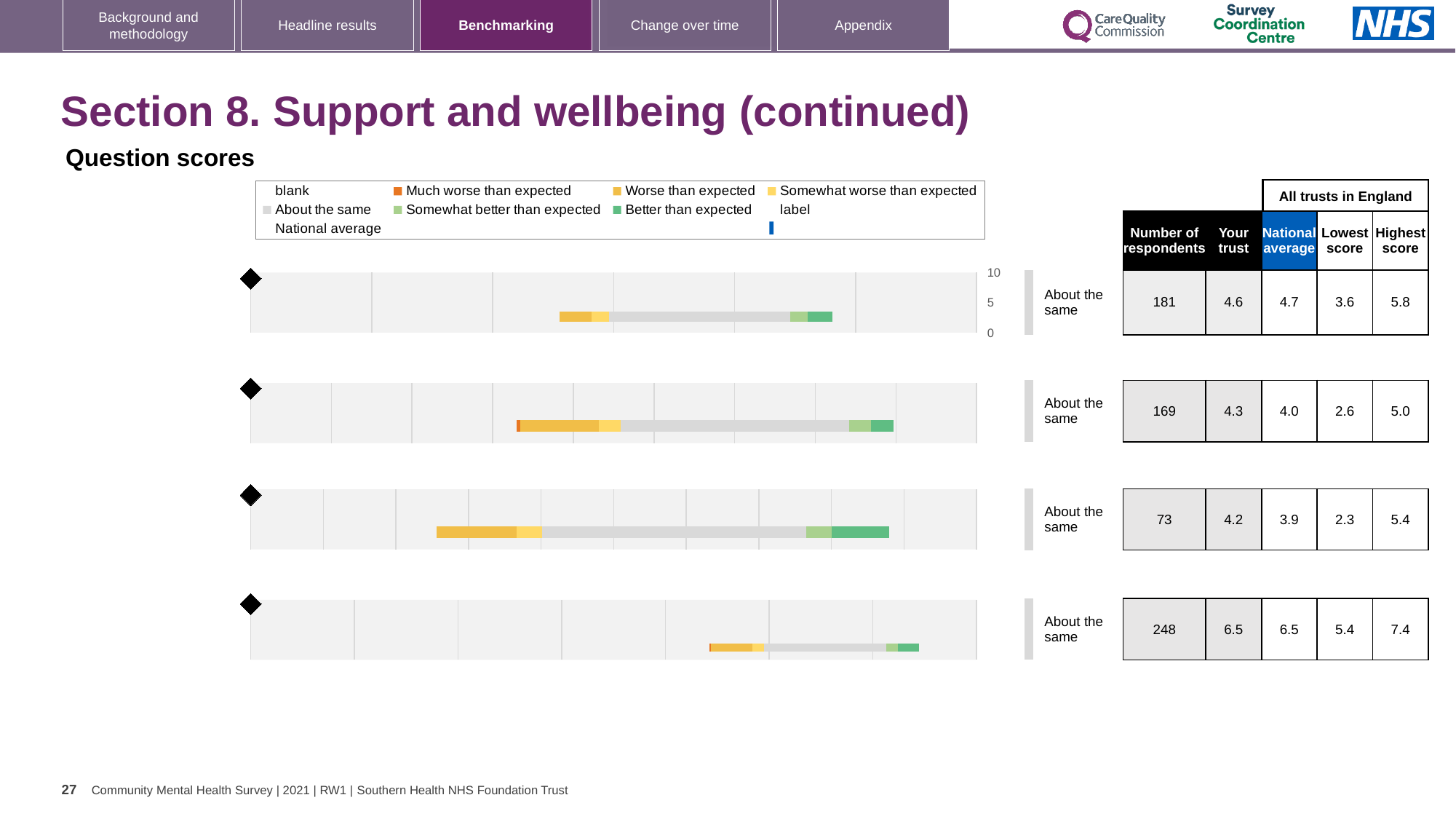
How many question score charts are shown on the slide? 4 For the bottom chart, what is the difference between the highest score and the lowest score? 2.0 For the top chart, which is larger: the 'Your trust' score or the national average? the national average (4.7) For the second chart from the top, how much higher is the 'Your trust' score than the national average? 0.3 Which chart has the lowest number of respondents? the third chart from the top (73) For the bottom chart, what is the highest score among all trusts in England? 7.4 For the top chart, what is the number of respondents shown in the table? 181 Which chart has the highest 'Your trust' score? the bottom chart (6.5) What kind of chart is used to show the question scores on this slide? bar chart For the second chart from the top, what is the 'Your trust' score? 4.3 What benchmark category is shown next to each of the four charts? About the same For the third chart from the top, what is the national average score? 3.9